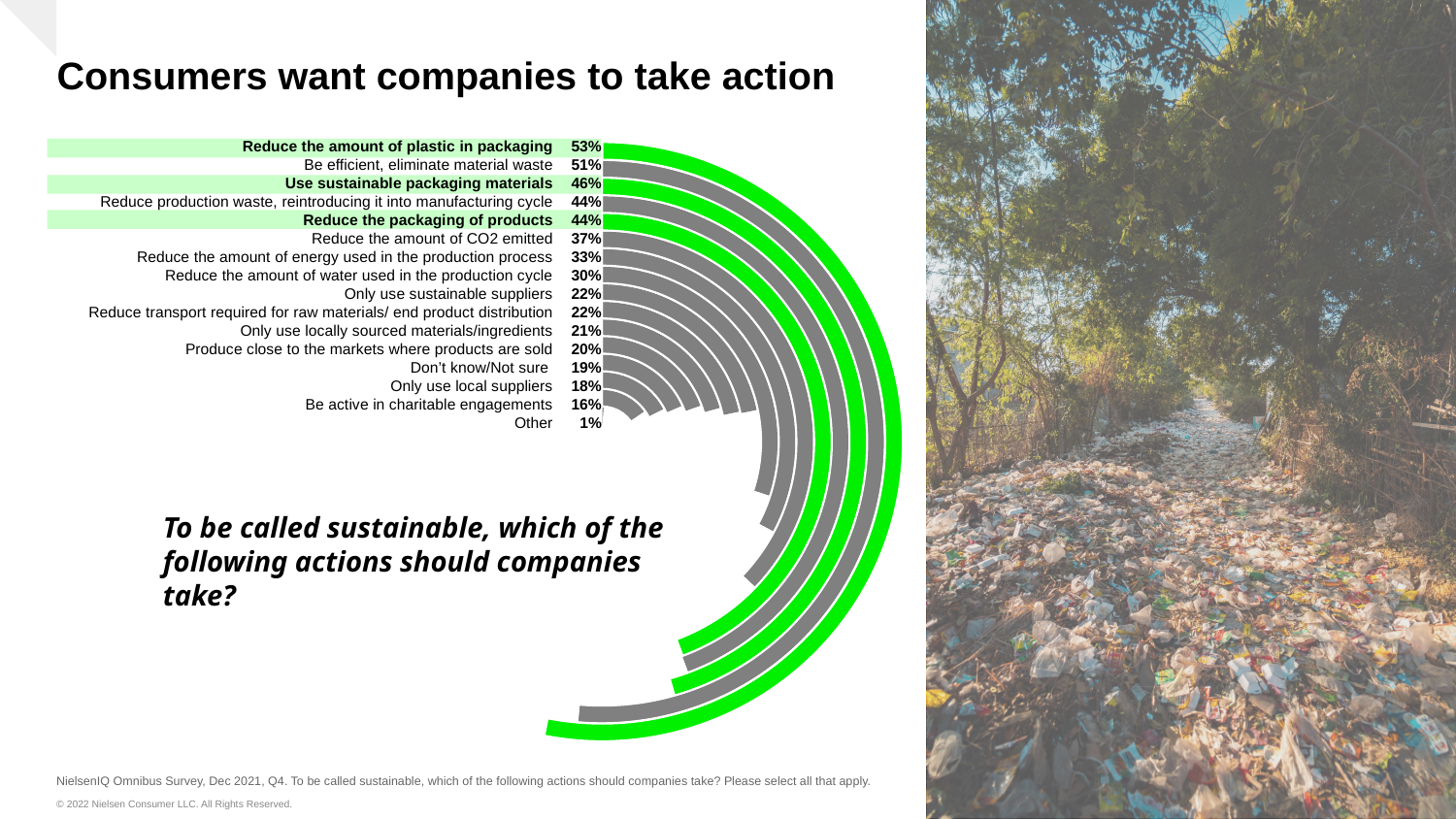
Which category has the lowest percentage in the chart? Other Which is larger: 'Reduce the amount of energy used in the production process' or 'Only use sustainable suppliers'? Reduce the amount of energy used in the production process What is the value for 'Only use local suppliers'? 18% Which two actions both have a value of 44%? Reduce production waste, reintroducing it into manufacturing cycle; Reduce the packaging of products How many categories are shown in the chart? 16 What kind of chart is shown on the slide? doughnut chart What percentage of consumers say companies should reduce the amount of plastic in packaging? 53% Which action has the highest percentage in the chart? Reduce the amount of plastic in packaging What colour are the bars for the highlighted packaging-related actions (e.g. 'Use sustainable packaging materials')? green What is the difference between 'Use sustainable packaging materials' and 'Reduce the amount of water used in the production cycle'? 16% What is the difference between 'Reduce the amount of plastic in packaging' and 'Be efficient, eliminate material waste'? 2% What is the value for 'Reduce the amount of CO2 emitted'? 37%